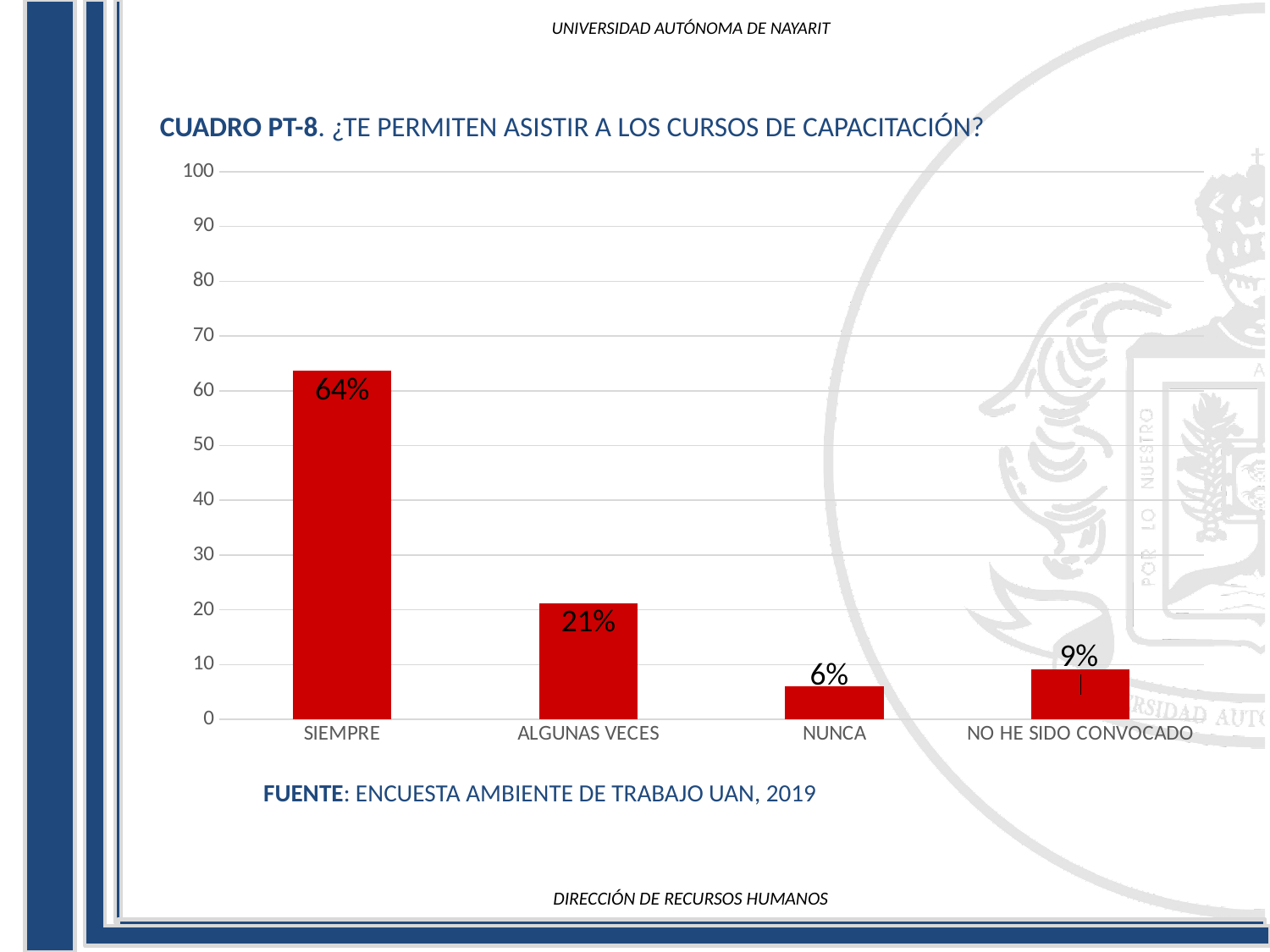
How many categories are shown on the x axis? 4 What is the source cited below the chart? ENCUESTA AMBIENTE DE TRABAJO UAN, 2019 Is the value for SIEMPRE greater or less than 60? greater What is the value for SIEMPRE? 64% What is the value for NUNCA? 6% Which category has the lowest value? NUNCA What is the value for NO HE SIDO CONVOCADO? 9% Which category has the highest value? SIEMPRE What is the value for ALGUNAS VECES? 21% What kind of chart is shown on the slide? bar chart What is the difference between the values for SIEMPRE and ALGUNAS VECES? 43% Which is larger, the value for NUNCA or the value for NO HE SIDO CONVOCADO? NO HE SIDO CONVOCADO